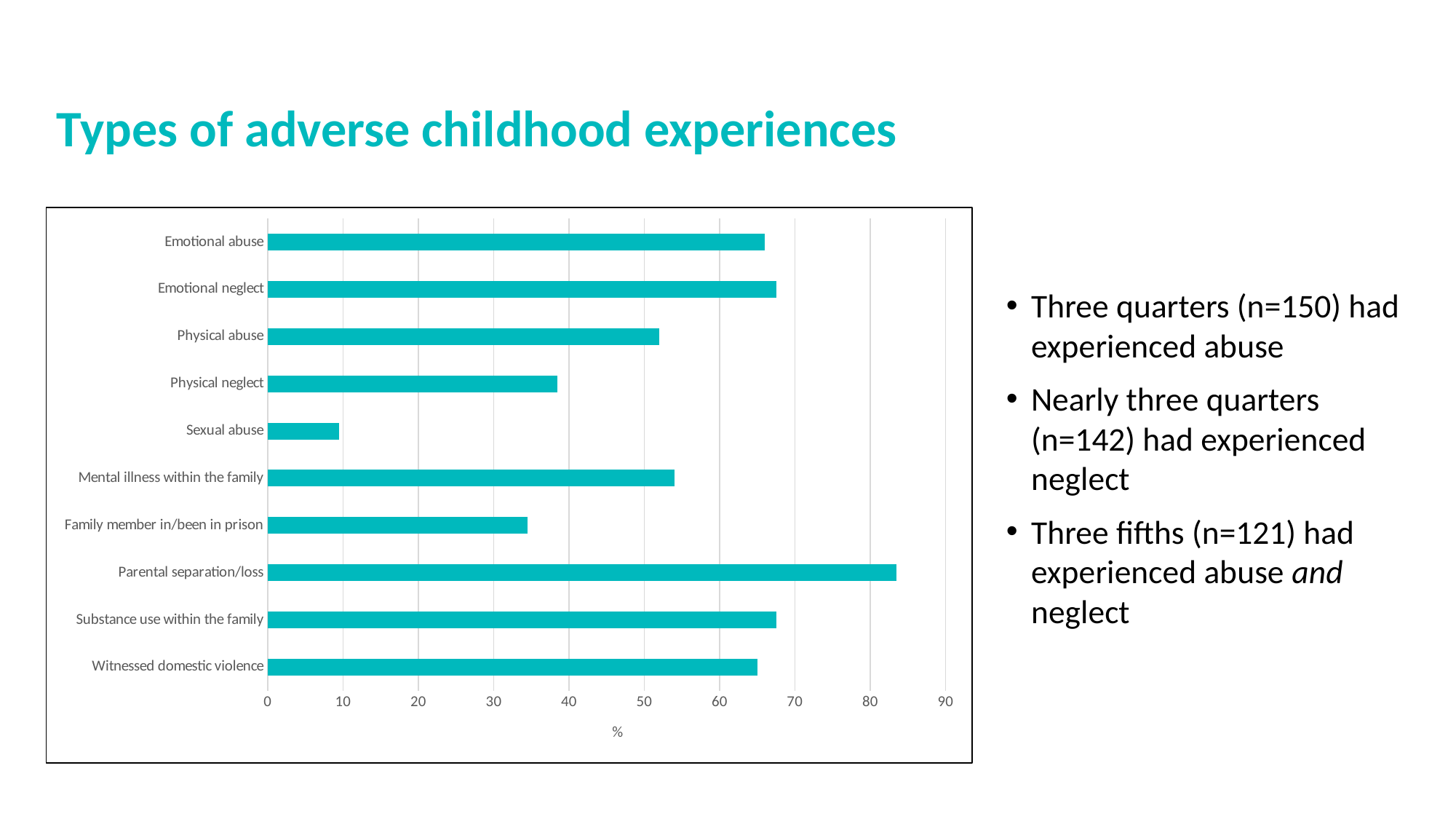
What kind of chart is shown on the slide? Bar chart How many categories of adverse childhood experience are plotted in the chart? 10 Is the value for Mental illness within the family greater or less than 50? greater Which category has the highest value in the chart? Parental separation/loss Which is larger, the value for Physical abuse or the value for Physical neglect? Physical abuse Is the value for Family member in/been in prison greater or less than 40? less Which category has the lowest value in the chart? Sexual abuse Is the value for Parental separation/loss greater or less than 80? greater Which is larger, the value for Sexual abuse or the value for Family member in/been in prison? Family member in/been in prison What is the label on the horizontal axis of the chart? %